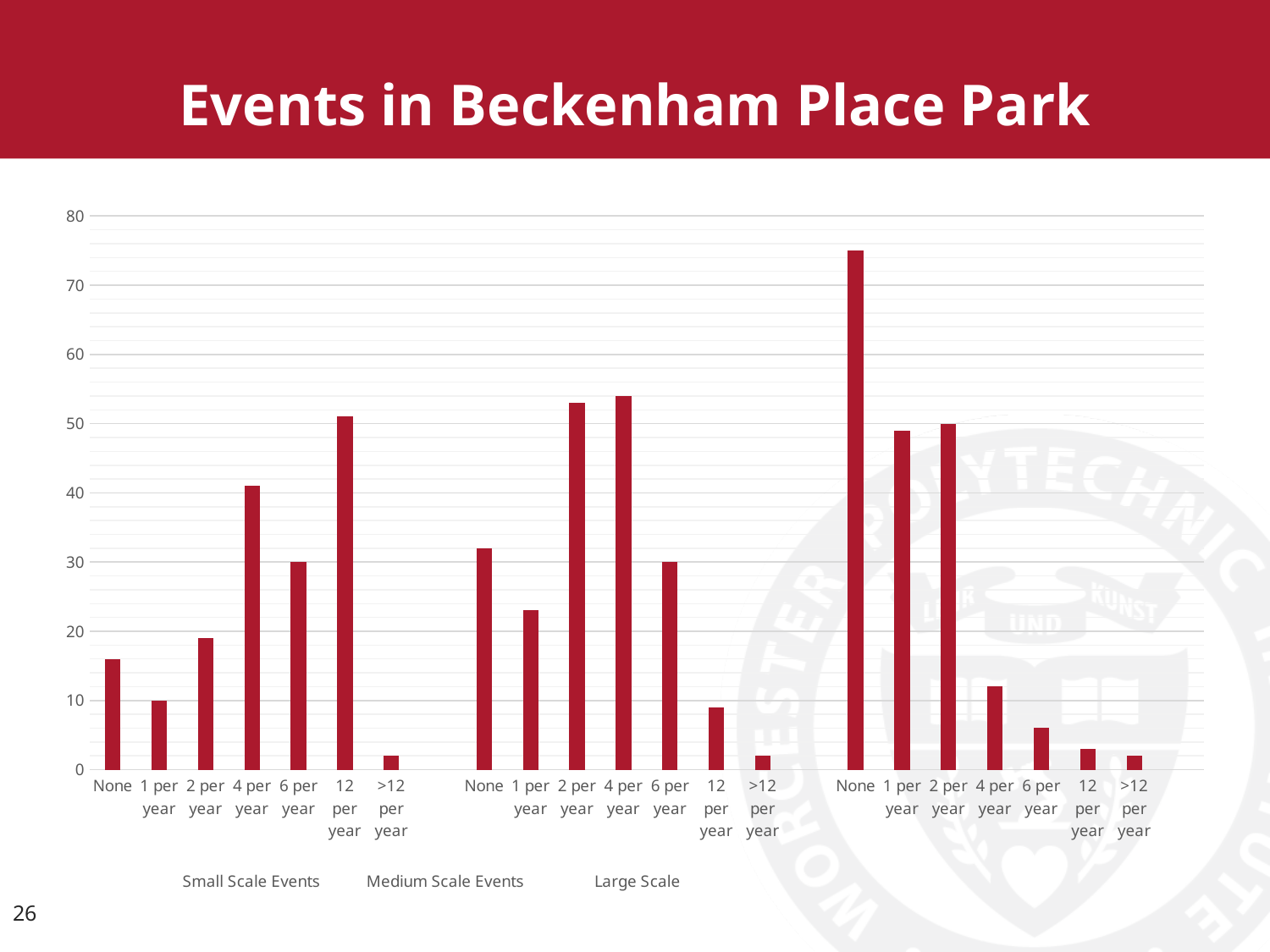
Is the value for None in the Large Scale group greater or less than 70? greater In the Small Scale Events group, which is larger: None or 1 per year? None Which bar is the tallest in the whole chart? None (Large Scale) What kind of chart is shown on the slide? bar chart Is the value for 1 per year in the Medium Scale Events group greater or less than 20? greater Which is larger: None in the Large Scale group or None in the Medium Scale Events group? Large Scale Is the value for 4 per year in the Large Scale group greater or less than 20? less In the Large Scale group, do the values generally rise or fall from None to >12 per year? fall How many frequency categories are shown in each event-scale group? 7 Within the Small Scale Events group, which category has the lowest value? >12 per year Within the Medium Scale Events group, which category has the lowest value? >12 per year Within the Small Scale Events group, which category has the highest value? 12 per year